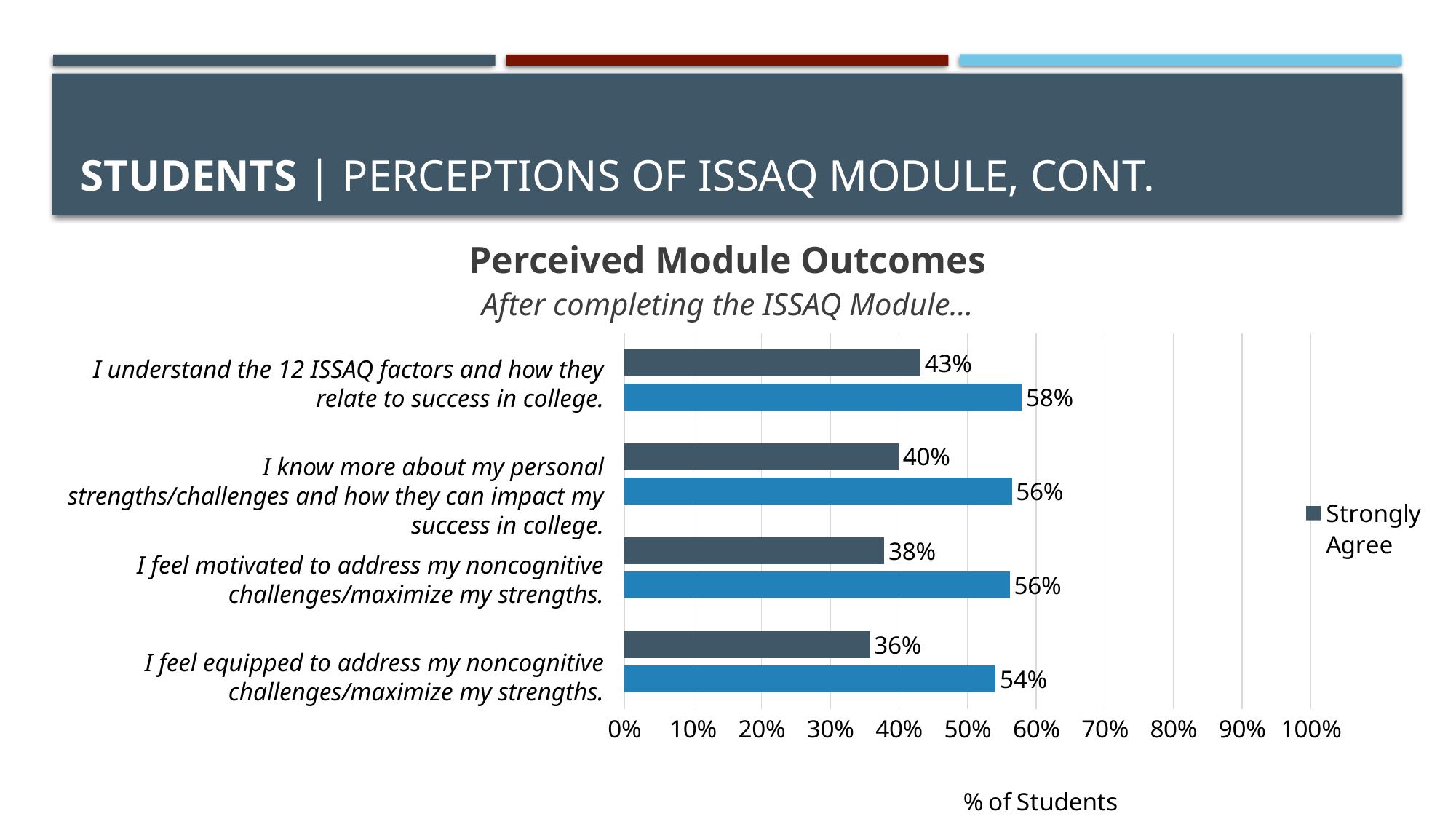
What is the label on the horizontal axis of the chart? % of Students What is the Strongly Agree value for "I feel motivated to address my noncognitive challenges/maximize my strengths"? 38% Which statement has the highest Strongly Agree percentage? I understand the 12 ISSAQ factors and how they relate to success in college. What is the difference between the Strongly Agree values for "I understand the 12 ISSAQ factors..." and "I feel equipped to address my noncognitive challenges..."? 7% How many series does the legend list? 1 Which statement has the lowest Strongly Agree percentage? I feel equipped to address my noncognitive challenges/maximize my strengths. What is the Strongly Agree value for "I feel equipped to address my noncognitive challenges/maximize my strengths"? 36% How many statements are shown on the chart? 4 What percentage of students strongly agree with the statement "I understand the 12 ISSAQ factors and how they relate to success in college"? 43% What type of chart is shown on the slide? bar chart Which has a larger Strongly Agree value: "I know more about my personal strengths/challenges..." or "I feel motivated to address my noncognitive challenges..."? I know more about my personal strengths/challenges and how they can impact my success in college. Is the Strongly Agree value for "I know more about my personal strengths/challenges..." greater or less than 50%? less